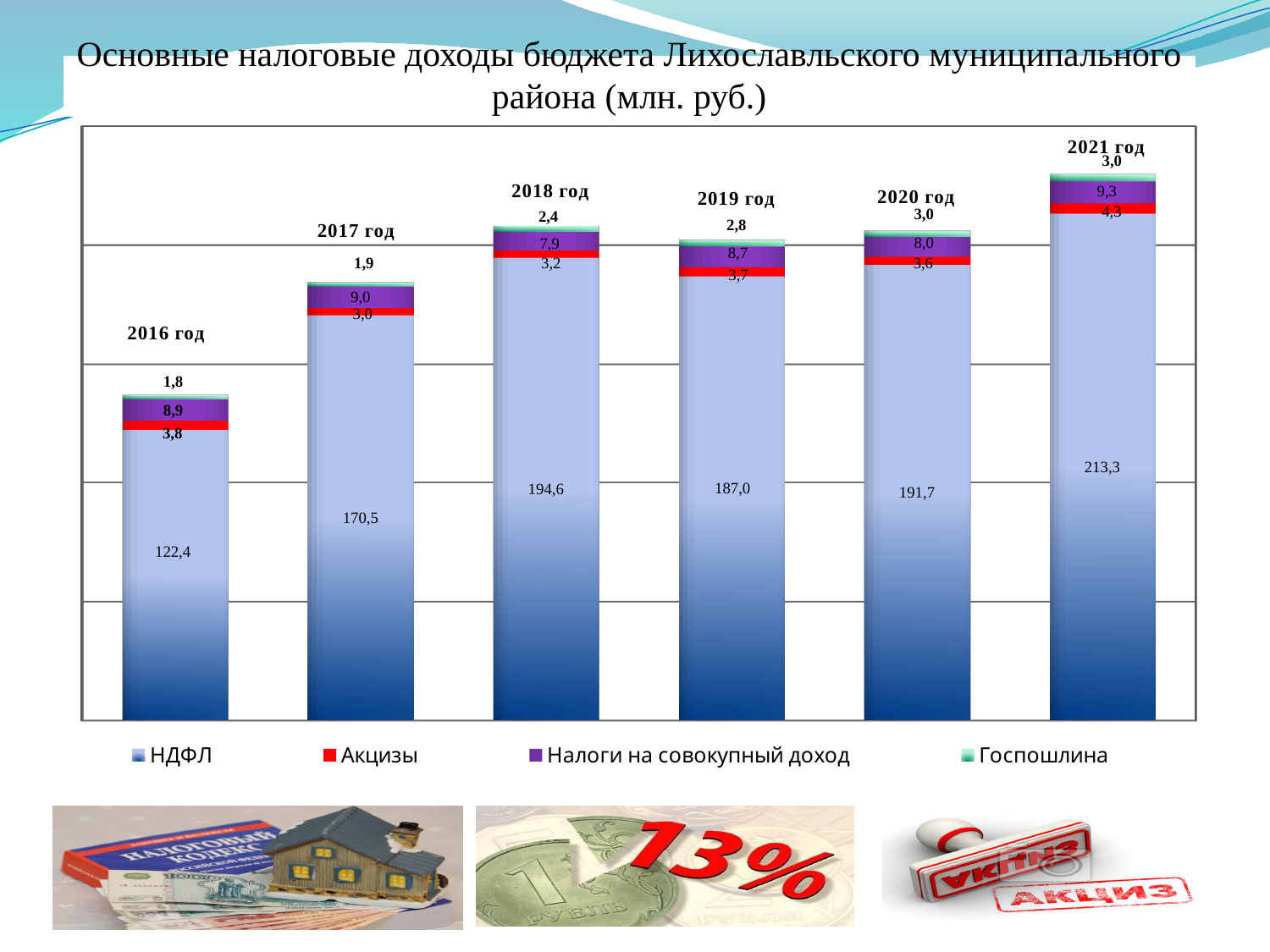
What is the НДФЛ value for 2016 год? 122,4 How many years are shown on the chart? 6 What is the Налоги на совокупный доход value for 2019 год? 8,7 What is the Акцизы value for 2021 год? 4,3 What is the Госпошлина value for 2018 год? 2,4 Which is larger, the Налоги на совокупный доход value for 2017 год or for 2018 год? 2017 год What is the total of the stacked bar for 2016 год? 136,9 In which year is the НДФЛ value highest? 2021 год What is the difference between the НДФЛ values for 2021 год and 2016 год? 90,9 How many series does the legend list? 4 What kind of chart is shown on the slide? Stacked bar chart In which year is the НДФЛ value lowest? 2016 год